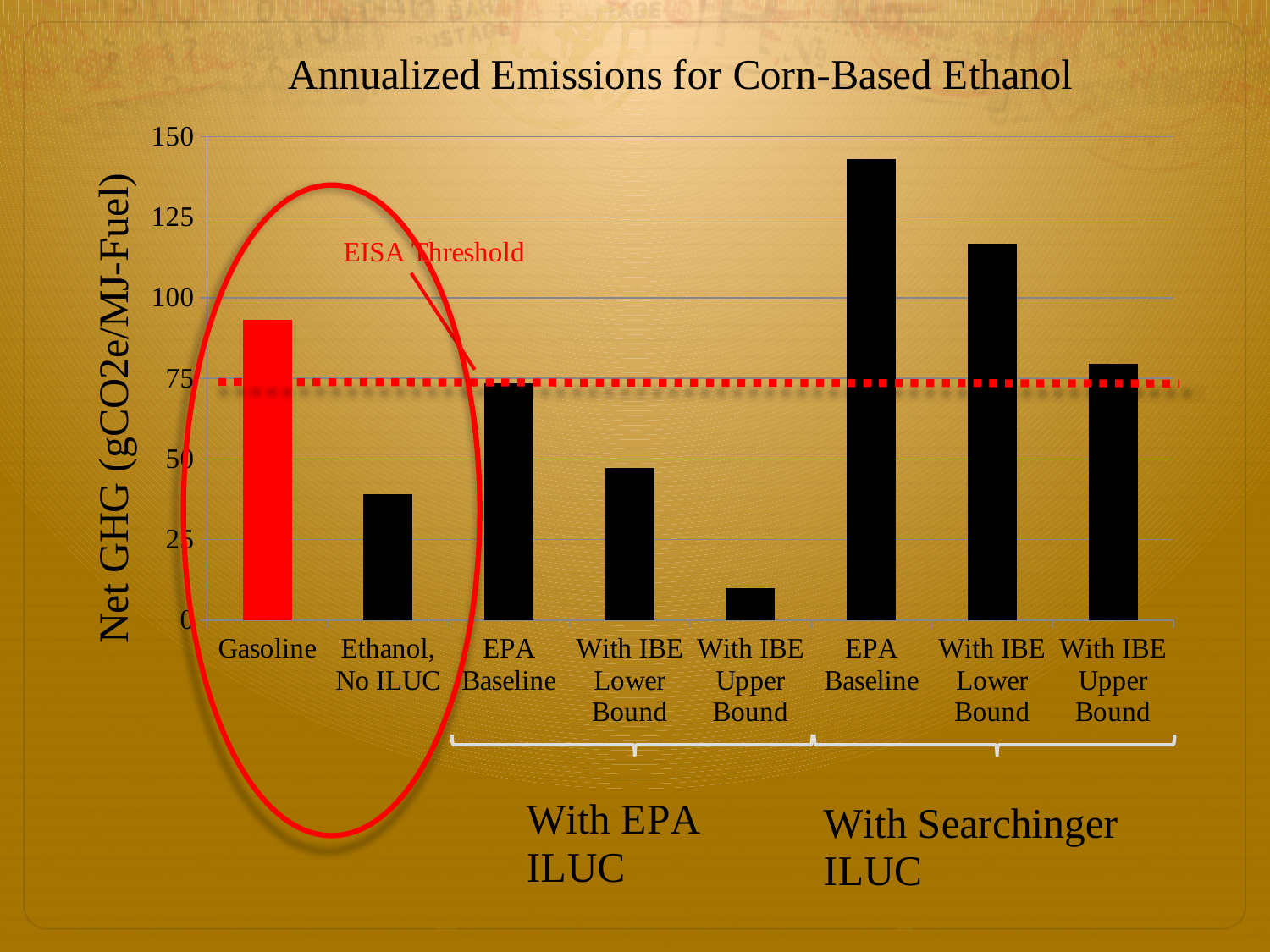
Is the value for With IBE Upper Bound under With EPA ILUC greater or less than 25? less Which is larger, the value for Gasoline or the value for Ethanol, No ILUC? Gasoline Which category has the highest bar? EPA Baseline (With Searchinger ILUC) Is the value for Gasoline greater or less than 75? greater How many bars are plotted in the chart? 8 What is the label of the vertical axis? Net GHG (gCO2e/MJ-Fuel) Is the value for With IBE Lower Bound under With Searchinger ILUC greater or less than 100? greater What is the title of the chart? Annualized Emissions for Corn-Based Ethanol Which category has the lowest bar? With IBE Upper Bound (With EPA ILUC) What type of chart is shown on the slide? bar chart